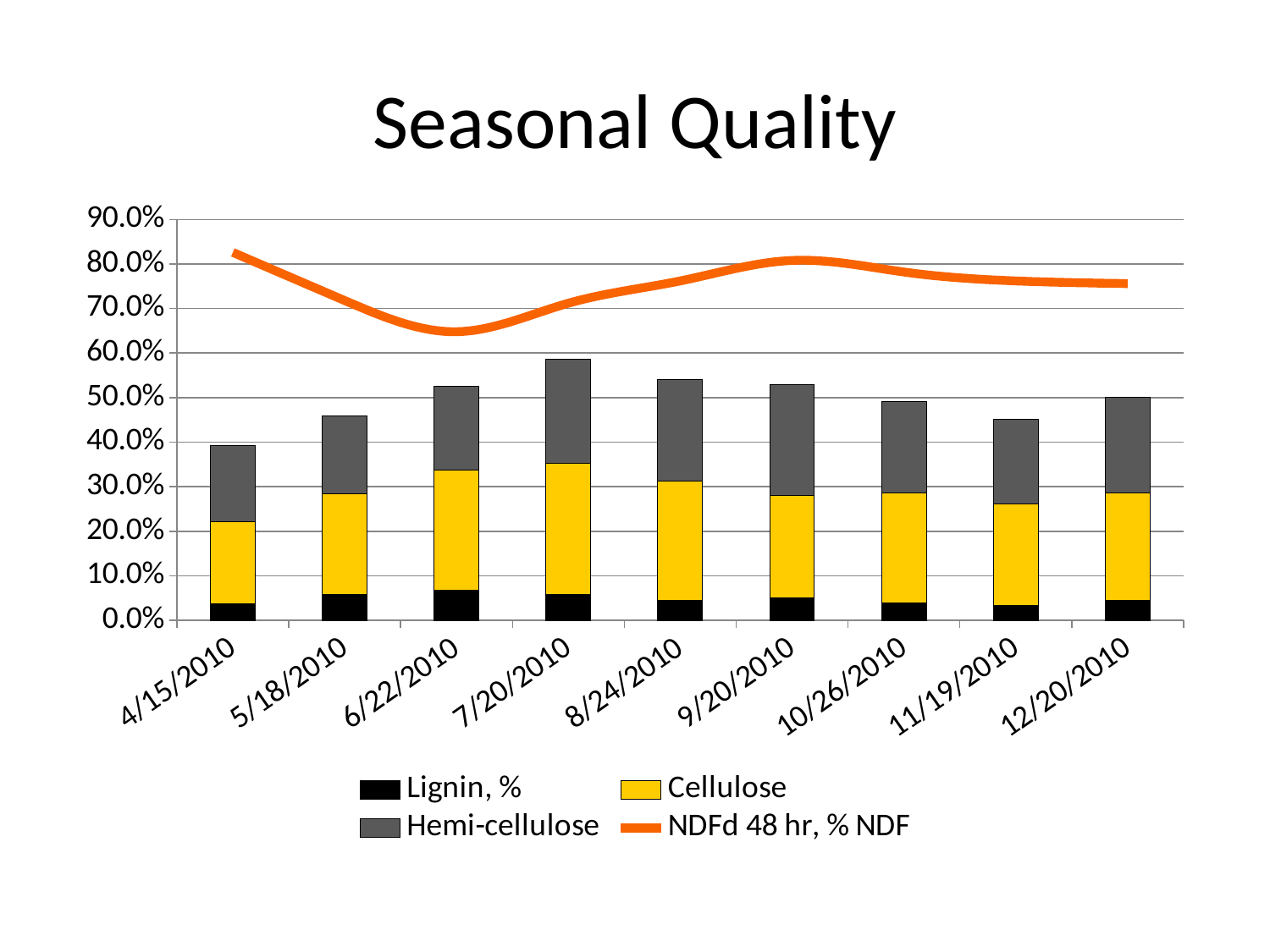
What is the title of the chart? Seasonal Quality How many series does the legend list? 4 How many dates are shown on the x axis? 9 On which date is the NDFd 48 hr, % NDF line at its lowest? 6/22/2010 Which series is plotted as the orange line? NDFd 48 hr, % NDF Is the total of the stacked bar for 7/20/2010 greater or less than 50.0%? greater Is the NDFd 48 hr, % NDF value for 4/15/2010 greater or less than 80.0%? greater Is the NDFd 48 hr, % NDF value for 6/22/2010 greater or less than 70.0%? less On which date is the stacked bar the tallest? 7/20/2010 Which stacked bar is taller, 7/20/2010 or 11/19/2010? 7/20/2010 On which date is the stacked bar the shortest? 4/15/2010 What kind of chart is this? Stacked bar chart with a line